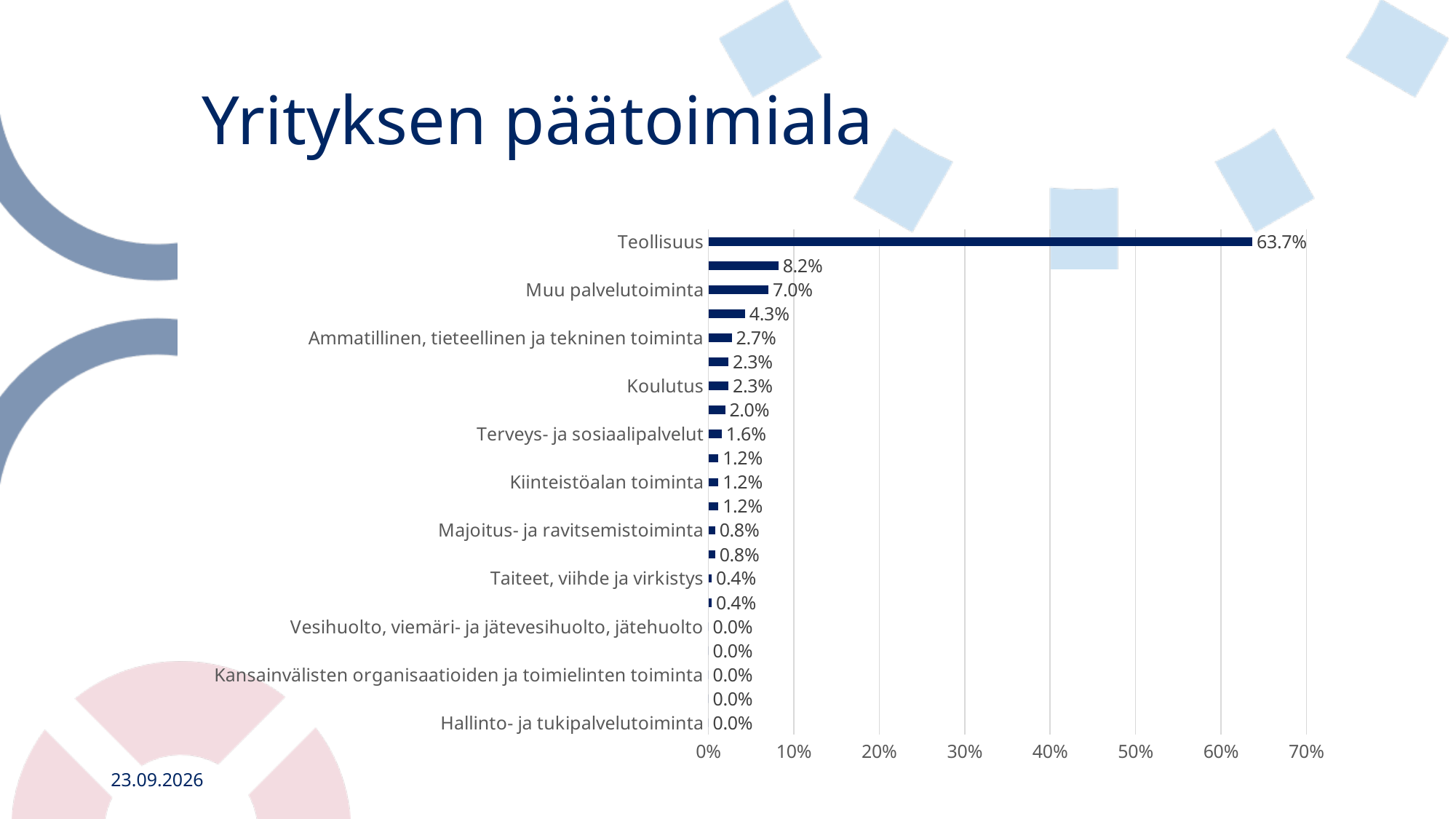
What is the value for Terveys- ja sosiaalipalvelut? 1.6% What is the value for Koulutus? 2.3% What is the difference between the values for Teollisuus and Muu palvelutoiminta? 56.7% Is the value for Teollisuus greater or less than 60%? greater What kind of chart is shown on the slide? bar chart Which category has the highest value? Teollisuus What is the value for Muu palvelutoiminta? 7.0% What is the value for Ammatillinen, tieteellinen ja tekninen toiminta? 2.7% What is the value for Teollisuus? 63.7% What is the value for Majoitus- ja ravitsemistoiminta? 0.8% Which has a larger value, Koulutus or Kiinteistöalan toiminta? Koulutus What is the title of the slide? Yrityksen päätoimiala